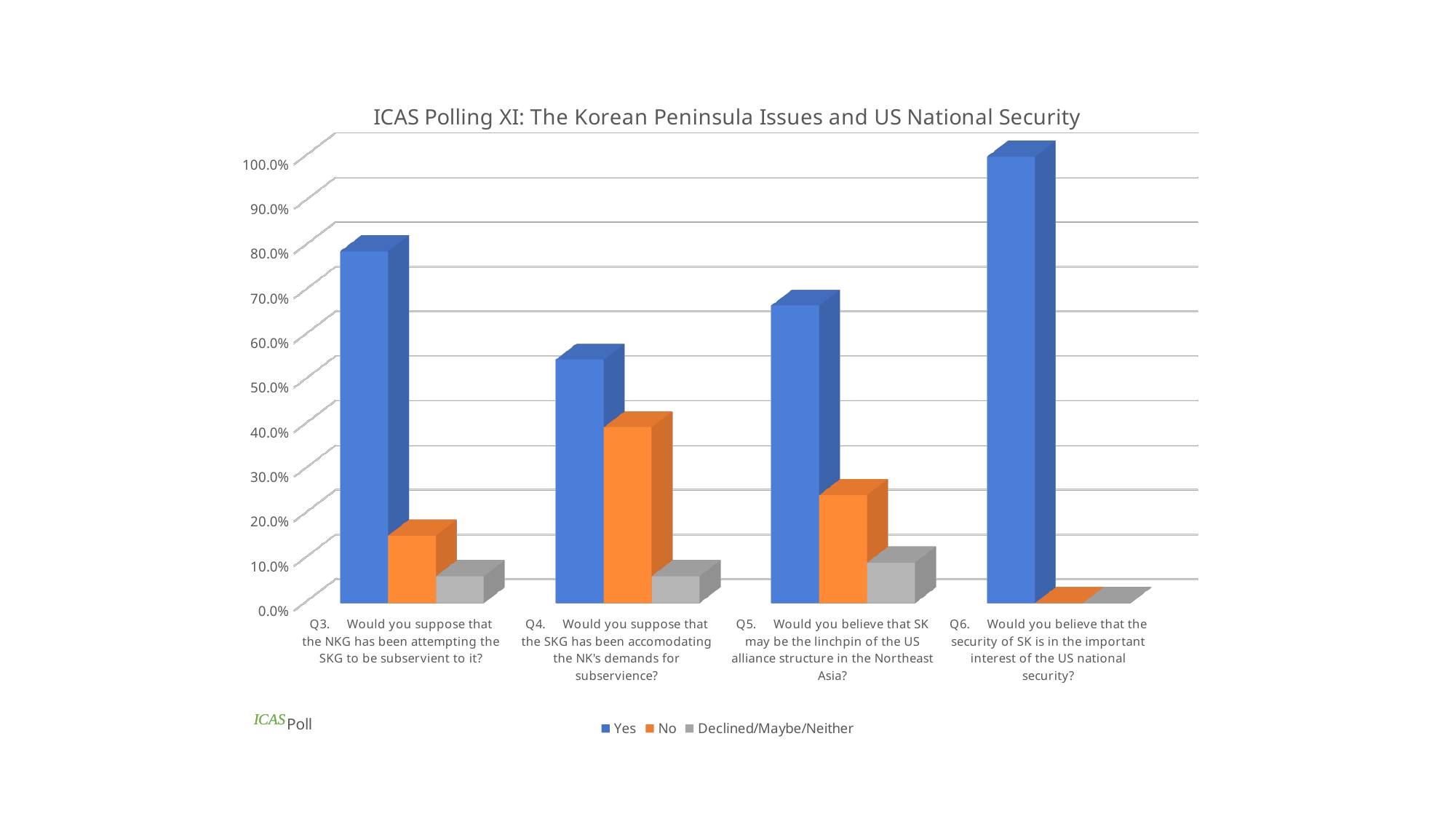
Is the 'Yes' value for Q6 greater or less than 90.0%? greater How many question categories are shown on the x axis? 4 Is the 'Yes' value for Q4 greater or less than 60.0%? less Which question has the highest 'No' value? Q4 Which question has the highest 'Yes' value? Q6 Which question has the lowest 'Yes' value? Q4 How many series does the legend list? 3 What is the title of the chart? ICAS Polling XI: The Korean Peninsula Issues and US National Security Is the 'No' value for Q4 greater or less than 30.0%? greater Which is larger, the 'Yes' value for Q3 or the 'Yes' value for Q4? Q3 What kind of chart is shown on the slide? bar chart